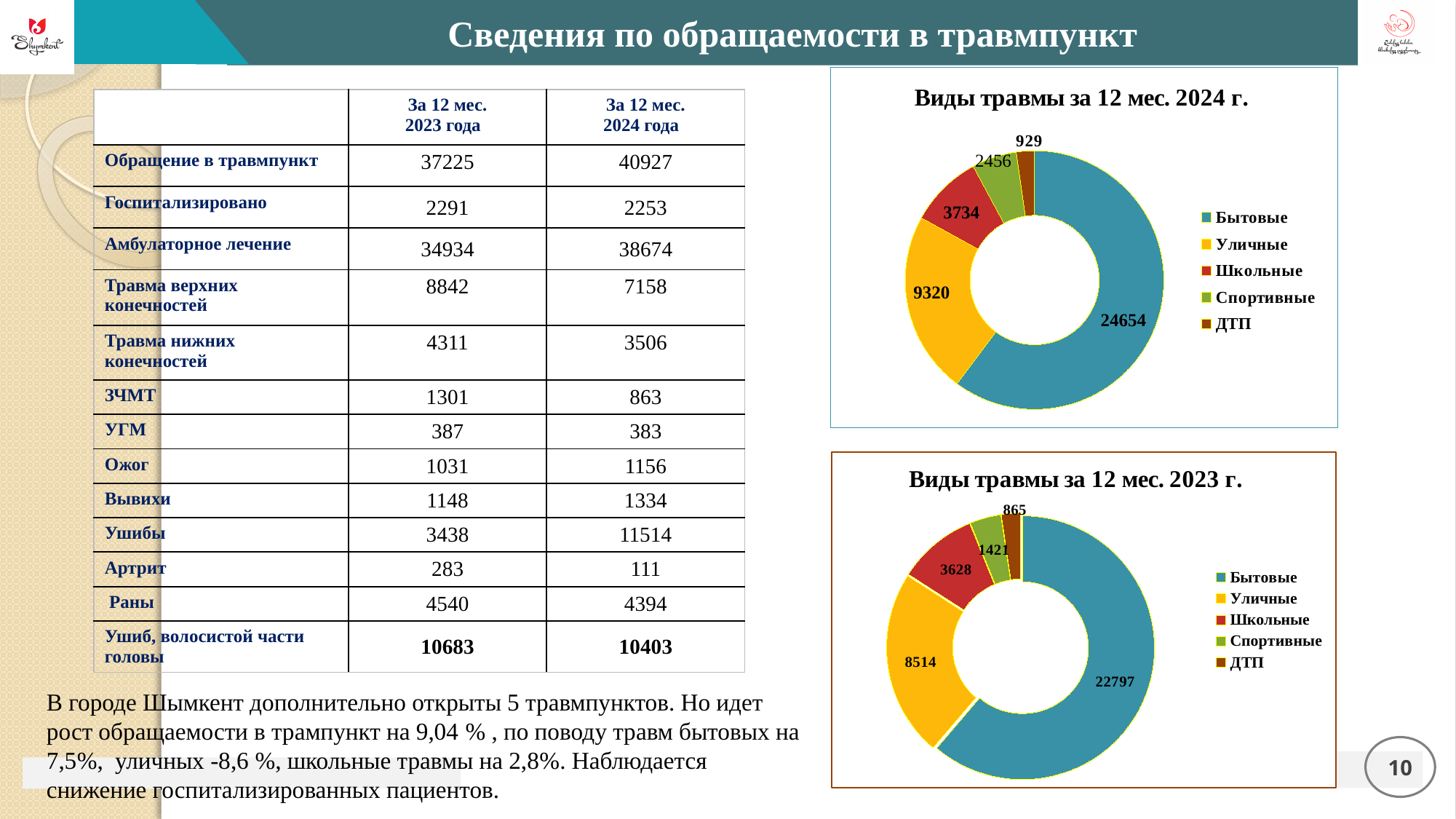
In the chart 'Виды травмы за 12 мес. 2024 г.', what is the value for ДТП? 929 What type of chart is 'Виды травмы за 12 мес. 2024 г.'? Doughnut chart In the chart 'Виды травмы за 12 мес. 2024 г.', which colour represents Уличные? Yellow In the chart 'Виды травмы за 12 мес. 2023 г.', what is the total of all categories? 37225 In the chart 'Виды травмы за 12 мес. 2024 г.', what is the value for Бытовые? 24654 In the chart 'Виды травмы за 12 мес. 2023 г.', what is the value for Уличные? 8514 In the chart 'Виды травмы за 12 мес. 2023 г.', which category has the smallest value? ДТП Which is larger: Школьные in the 2024 chart or Школьные in the 2023 chart? Школьные in the 2024 chart (3734) In the chart 'Виды травмы за 12 мес. 2024 г.', what is the difference between Бытовые and Уличные? 15334 How many categories are shown in the chart 'Виды травмы за 12 мес. 2023 г.'? 5 In the chart 'Виды травмы за 12 мес. 2024 г.', which category has the largest value? Бытовые In the chart 'Виды травмы за 12 мес. 2023 г.', what is the value for Спортивные? 1421